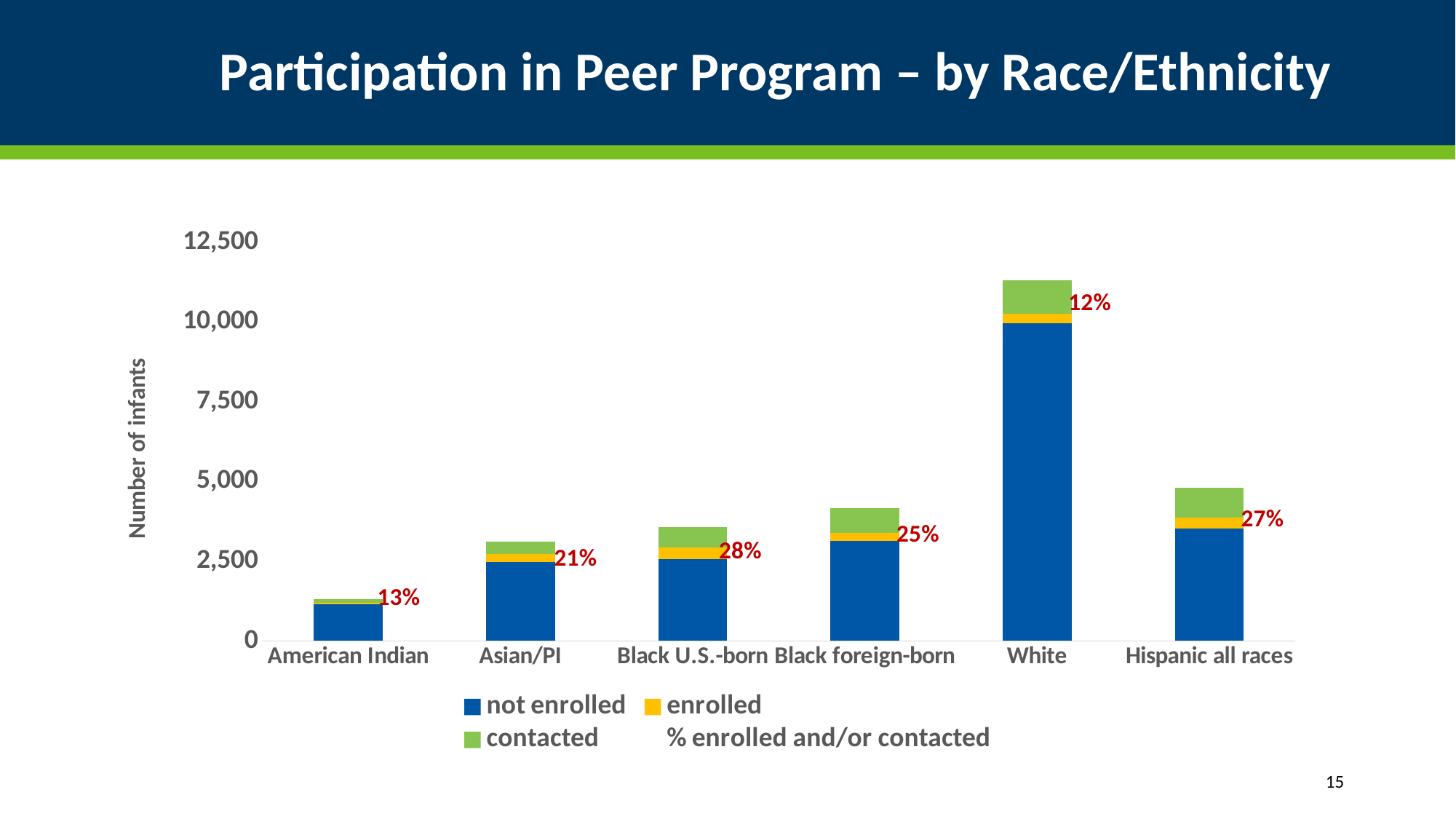
Which race/ethnicity group has the highest % enrolled and/or contacted? Black U.S.-born What is the % enrolled and/or contacted for White infants? 12% Is the total number of infants for White greater or less than 10,000? greater Which race/ethnicity group has the lowest % enrolled and/or contacted? White How many entries does the legend list? 4 What is the % enrolled and/or contacted for Hispanic all races? 27% Which has a higher % enrolled and/or contacted, Hispanic all races or Black foreign-born? Hispanic all races Is the total number of infants for American Indian greater or less than 2,500? less How many race/ethnicity categories are shown on the x axis? 6 What is the difference in percentage points between the % enrolled and/or contacted for Black U.S.-born and White infants? 16 percentage points Which race/ethnicity group has the tallest stacked bar (largest number of infants)? White What is the % enrolled and/or contacted for Black U.S.-born infants? 28%